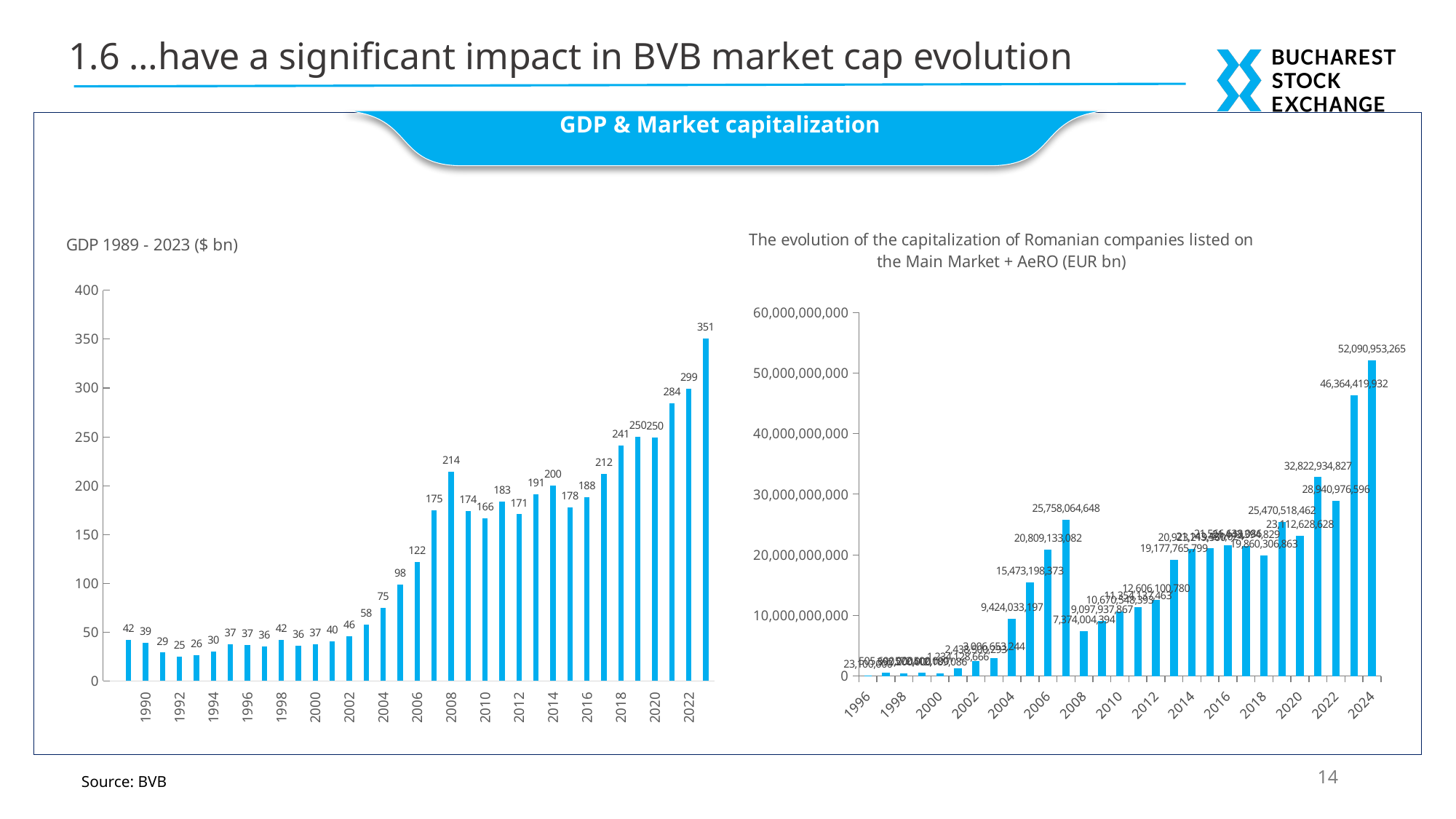
On the GDP 1989 - 2023 chart, what is the GDP value for 2008? 214 On the GDP 1989 - 2023 chart, which year has the highest GDP? 2023 On the market capitalization chart on the right, what is the value for 2007? 25,758,064,648 On the GDP 1989 - 2023 chart, which year has the lowest GDP? 1992 On the GDP 1989 - 2023 chart, which is larger, the value for 2009 or the value for 2010? 2009 On the GDP 1989 - 2023 chart, what is the GDP value for 2023? 351 On the GDP 1989 - 2023 chart, how many bars are plotted? 35 On the market capitalization chart on the right, which year has the highest value? 2024 On the GDP 1989 - 2023 chart, what is the difference between the 2022 value and the 2021 value? 15 On the GDP 1989 - 2023 chart, what kind of chart is used? Bar chart On the market capitalization chart on the right, is the value for 2008 greater or less than 10,000,000,000? less On the market capitalization chart on the right, what is the value for 2024? 52,090,953,265